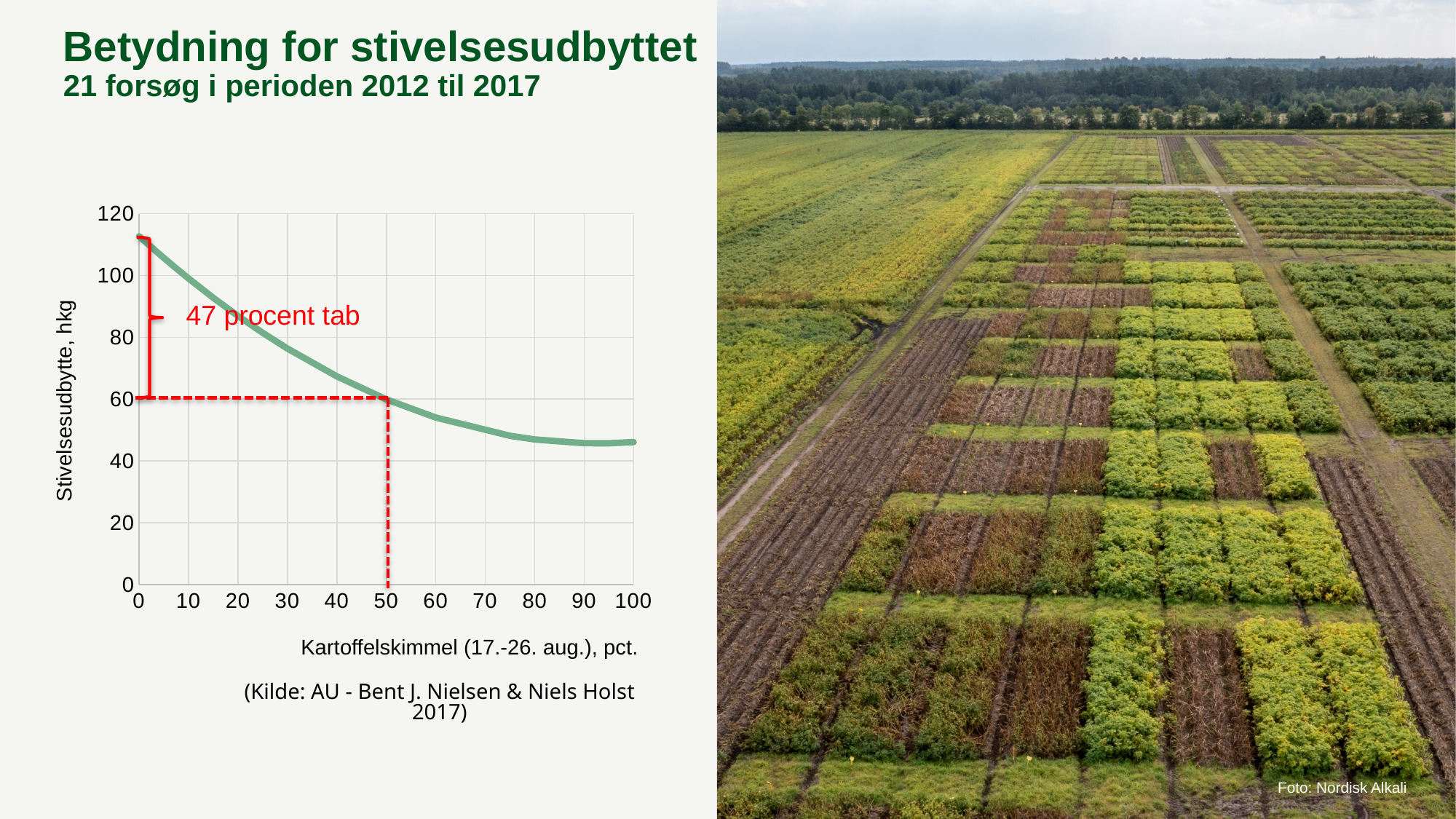
Is the Stivelsesudbytte at 80 pct. Kartoffelskimmel greater or less than 60 hkg? less What loss does the red annotation on the chart state? 47 procent tab Does the starch yield (Stivelsesudbytte) rise or fall as Kartoffelskimmel increases along the x axis? fall Which has the higher Stivelsesudbytte: 10 pct. or 70 pct. Kartoffelskimmel? 10 pct. What kind of chart is shown on the slide? line chart Is the Stivelsesudbytte at 20 pct. Kartoffelskimmel greater or less than 80 hkg? greater What is the label of the y axis of the chart? Stivelsesudbytte, hkg Is the Stivelsesudbytte at 100 pct. Kartoffelskimmel greater or less than 60 hkg? less According to the red dashed lines, what is the Stivelsesudbytte in hkg at 50 pct. Kartoffelskimmel? 60 At which Kartoffelskimmel percentage does the red dashed vertical line meet the x axis? 50